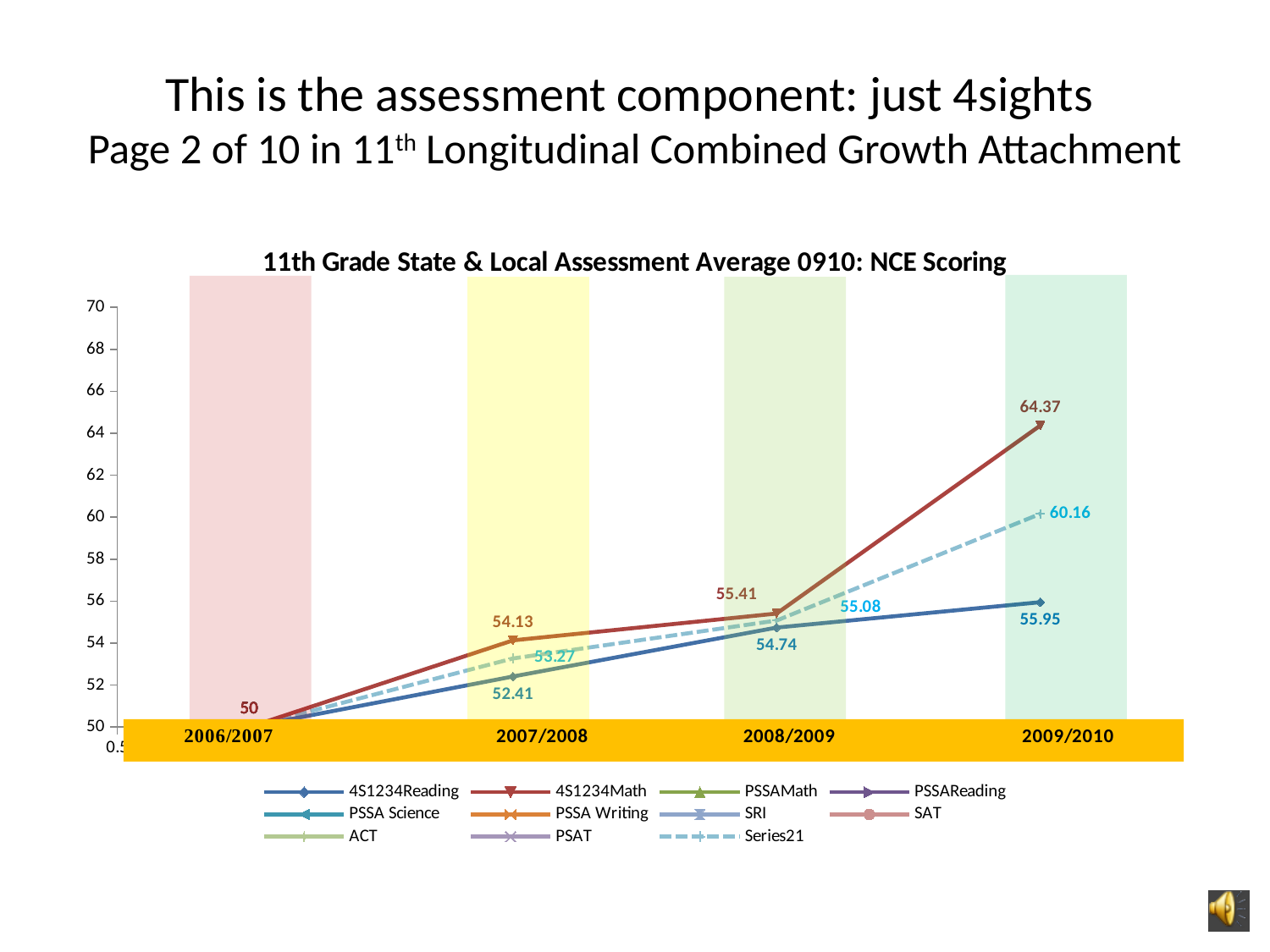
In which year does 4S1234Math reach its highest value? 2009/2010 What is the value for Series21 in 2009/2010? 60.16 What is the difference between the 4S1234Math values for 2009/2010 and 2008/2009? 8.96 Does the 4S1234Reading line rise or fall from 2006/2007 to 2009/2010? rise How many school years are shown on the x axis? 4 How many series does the legend list? 11 What is the title of the chart? 11th Grade State & Local Assessment Average 0910: NCE Scoring What kind of chart is shown on the slide? line chart What is the value for 4S1234Reading in 2007/2008? 52.41 What is the value for 4S1234Math in 2009/2010? 64.37 In 2009/2010, which is larger: 4S1234Math or Series21? 4S1234Math What is the value for 4S1234Math in 2006/2007? 50